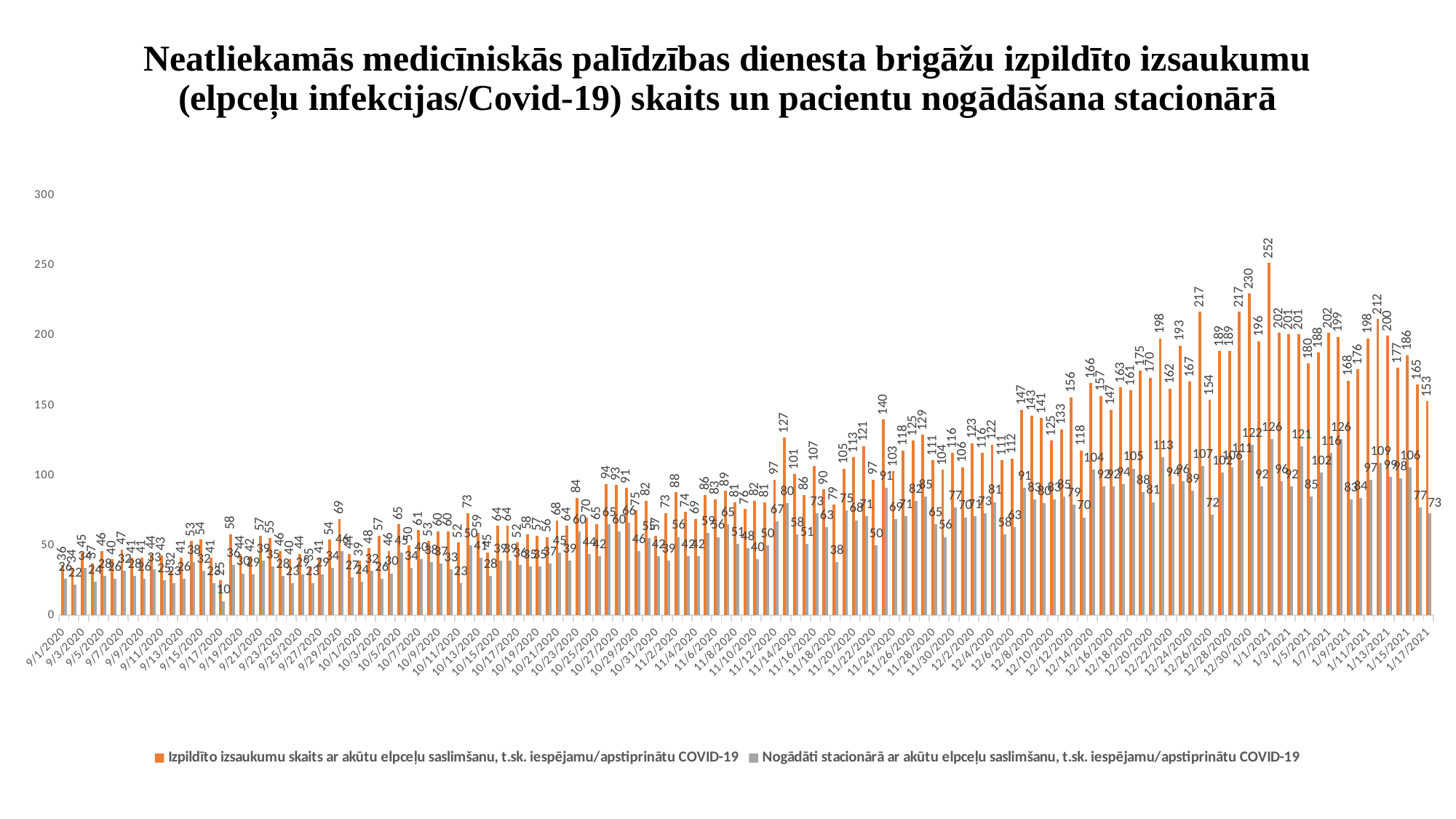
What is the highest value reached by the orange series (Izpildīto izsaukumu skaits)? 252 Overall, do the values of the orange series rise or fall from September 2020 to January 2021? rise What is the difference between the orange and grey values on 1/17/2021? 80 What is the lowest value of the orange series (Izpildīto izsaukumu skaits)? 25 What kind of chart is shown on the slide? bar chart Which colour represents the series 'Nogādāti stacionārā ar akūtu elpceļu saslimšanu, t.sk. iespējamu/apstiprinātu COVID-19'? grey What is the value of the grey series (Nogādāti stacionārā) on 1/17/2021? 73 What is the value of the orange series (Izpildīto izsaukumu skaits) on 1/17/2021? 153 On 1/17/2021, which series has the larger value, the orange (Izpildīto izsaukumu skaits) or the grey (Nogādāti stacionārā)? orange (Izpildīto izsaukumu skaits) How many series does the legend list? 2 Is the orange value on 1/17/2021 greater or less than 100? greater What is the value of the orange series (Izpildīto izsaukumu skaits) on 9/1/2020? 36